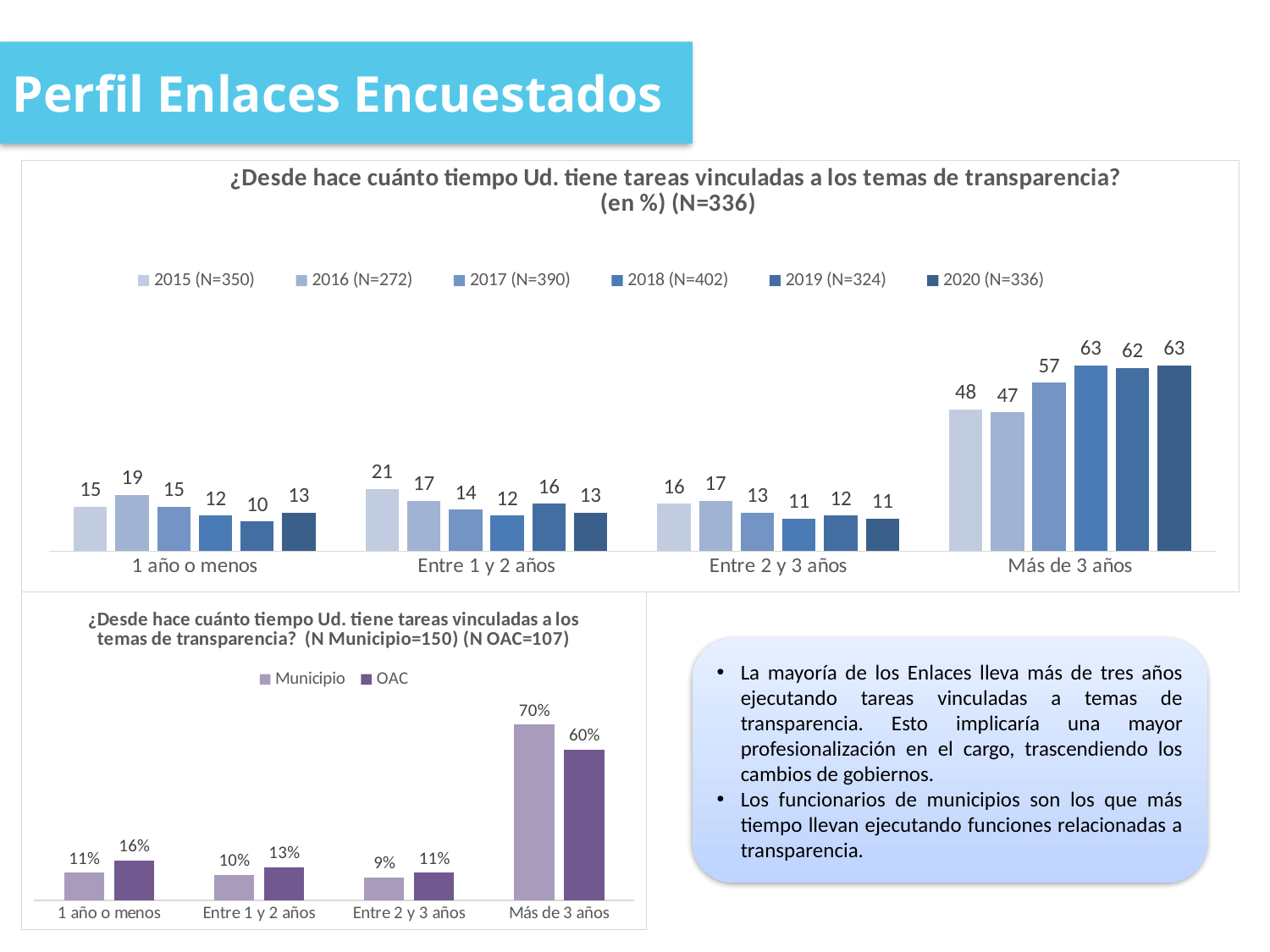
In the top chart (N=336), which series has the lowest value in the '1 año o menos' category? 2019 (N=324) In the top chart (N=336), what is the value for 2020 (N=336) in the 'Más de 3 años' category? 63 In the bottom-left chart (N Municipio=150), what is the difference between the OAC and Municipio values for 'Entre 1 y 2 años'? 3% In the top chart (N=336), how many categories are shown on the x axis? 4 In the bottom-left chart (N Municipio=150), which is larger for 'Más de 3 años': Municipio or OAC? Municipio What type of chart is the bottom-left chart (N Municipio=150)? Bar chart In the top chart (N=336), what is the difference between the 2018 (N=402) and 2015 (N=350) values in the 'Más de 3 años' category? 15 In the top chart (N=336), how many series does the legend list? 6 In the bottom-left chart (N Municipio=150), what is the Municipio value for 'Más de 3 años'? 70% In the top chart (N=336), which category has the highest values across all years? Más de 3 años In the bottom-left chart (N Municipio=150), what is the OAC value for '1 año o menos'? 16% In the top chart (N=336), what is the value for 2015 (N=350) in the 'Entre 1 y 2 años' category? 21